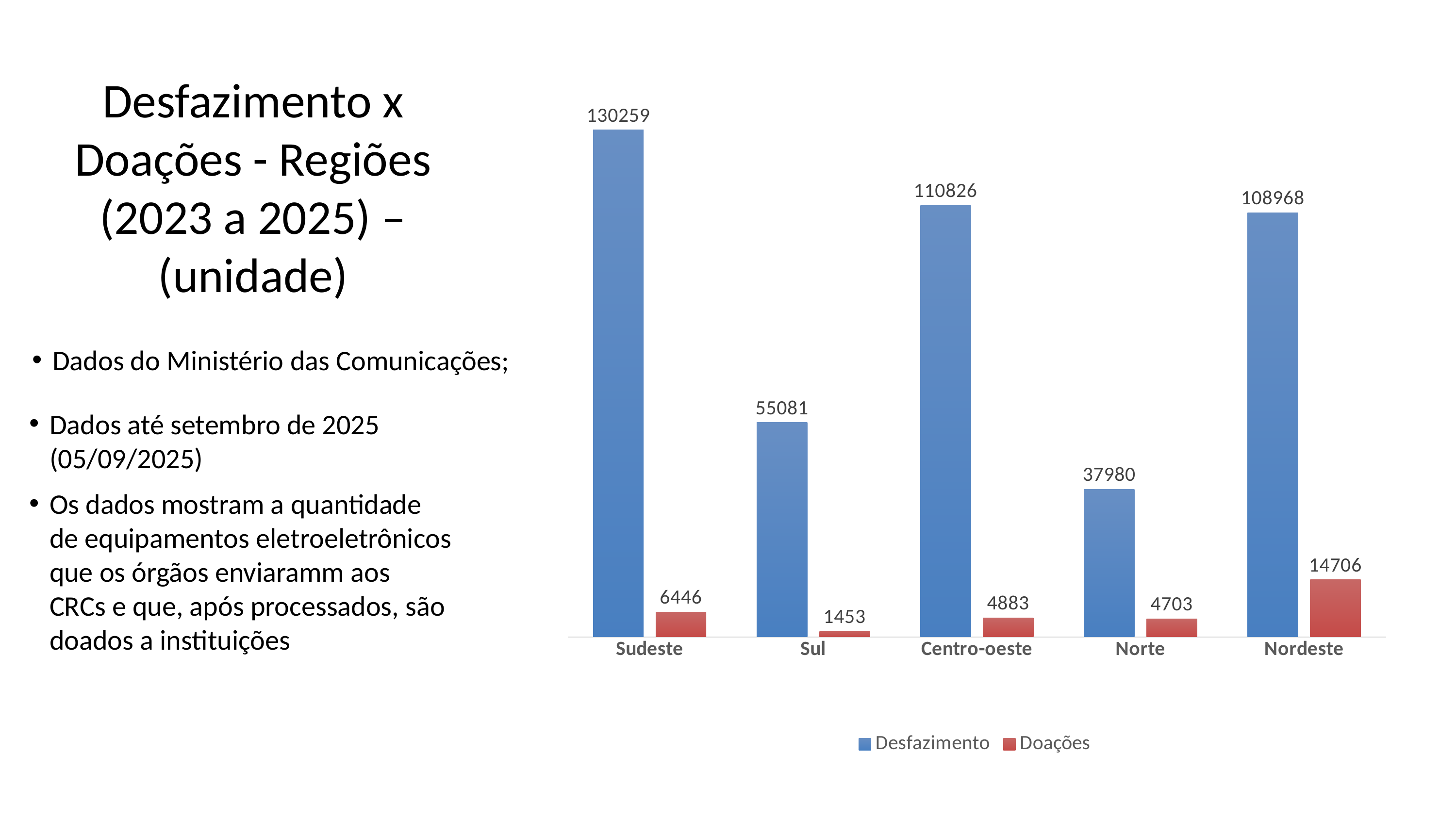
How many regions are shown on the x axis? 5 What is the Doações value for Nordeste? 14706 Which is larger, the Desfazimento value for Sul or for Norte? Sul What is the Desfazimento value for Sudeste? 130259 How many series does the legend list? 2 Which region has the lowest Doações value? Sul What kind of chart is shown on the slide? Bar chart Which region has the highest Desfazimento value? Sudeste What is the difference between the Desfazimento and Doações values for Sudeste? 123813 What is the Doações value for Sul? 1453 What is the Desfazimento value for Norte? 37980 What is the difference between the Doações values for Nordeste and Sudeste? 8260